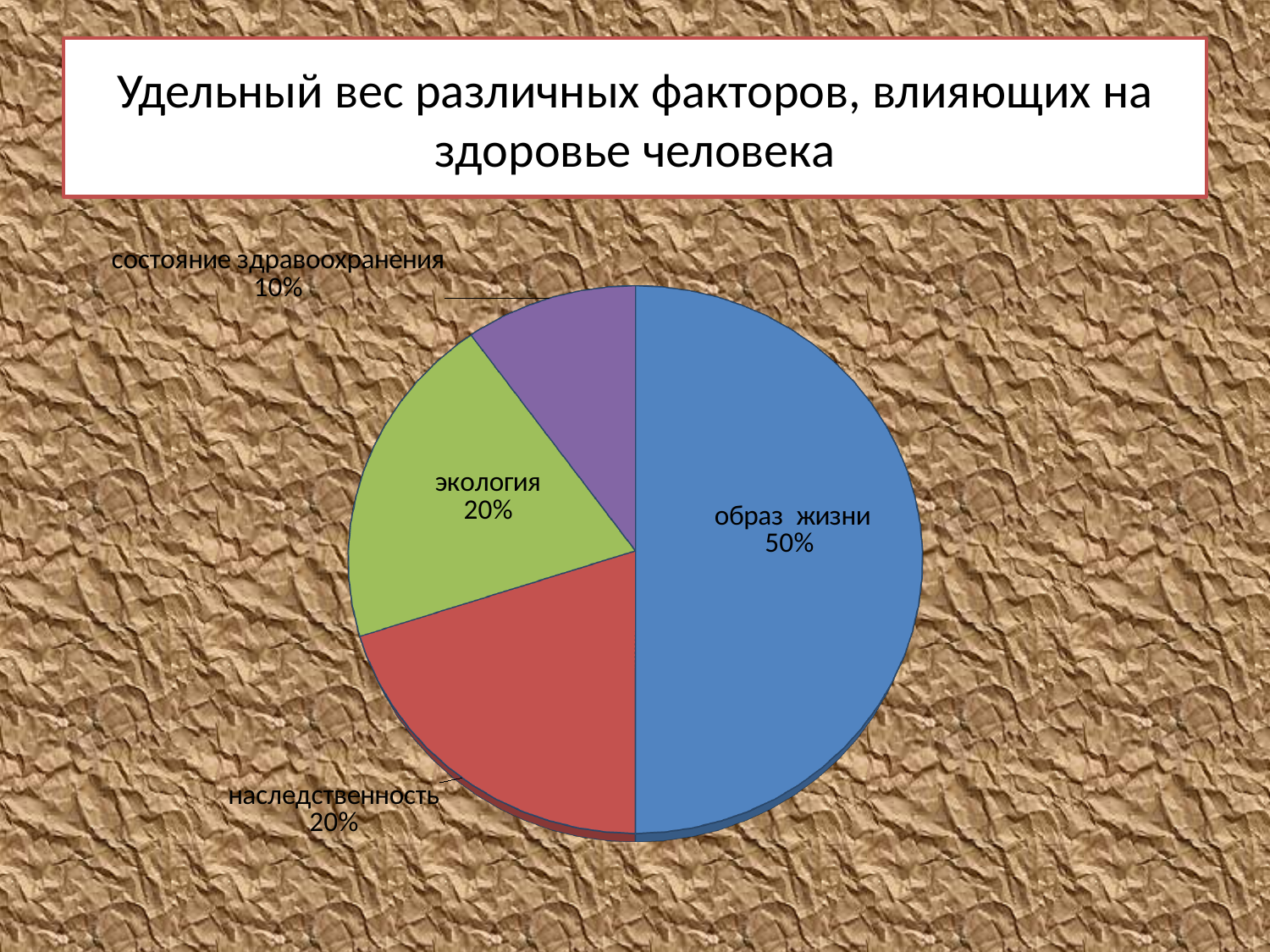
What is the value shown for состояние здравоохранения? 10% Which is larger, the share for наследственность or the share for состояние здравоохранения? наследственность What is the value shown for наследственность? 20% What kind of chart is shown on the slide? pie chart What colour is the slice for образ жизни? blue What is the title of the chart on the slide? Удельный вес различных факторов, влияющих на здоровье человека What share of the pie does образ жизни have? 50% How many slices does the pie chart have? 4 What is the difference between the shares of образ жизни and экология? 30% Which factor has the smallest share of the pie? состояние здравоохранения Which factor has the largest share of the pie? образ жизни What is the value shown for экология? 20%